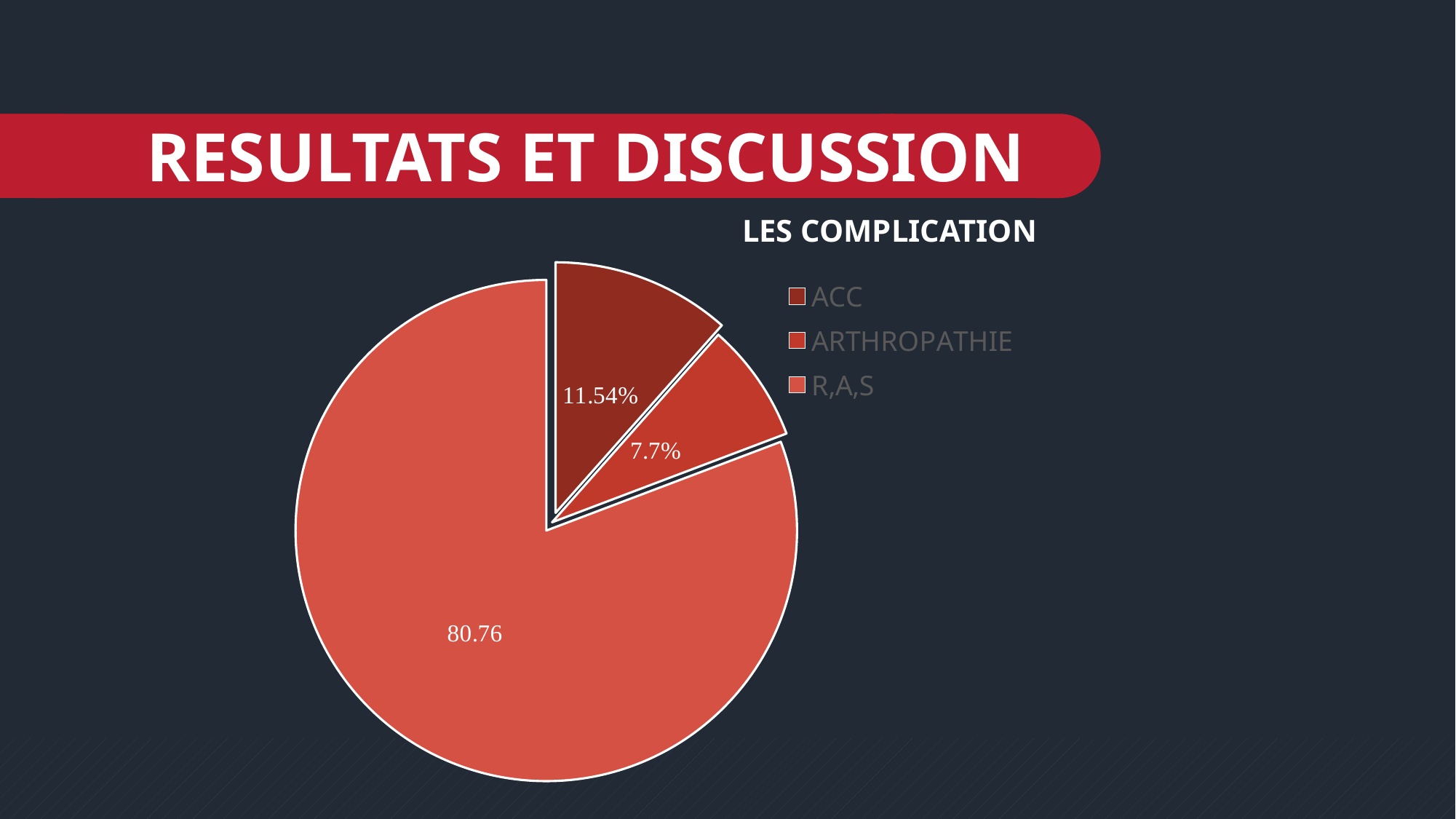
How many entries does the legend list? 3 What value is shown for the ARTHROPATHIE slice? 7.7% What kind of chart is shown on the slide? pie chart What is the title of the chart? LES COMPLICATION Which legend entry is shown with the darkest red colour? ACC What is the difference between the ACC value and the ARTHROPATHIE value? 3.84% Which category has the largest slice of the pie? R,A,S How many slices does the pie chart have? 3 Which category has the smallest slice of the pie? ARTHROPATHIE Which is larger, the ACC slice or the ARTHROPATHIE slice? ACC What value is shown for the ACC slice? 11.54% What value is shown for the R,A,S slice? 80.76